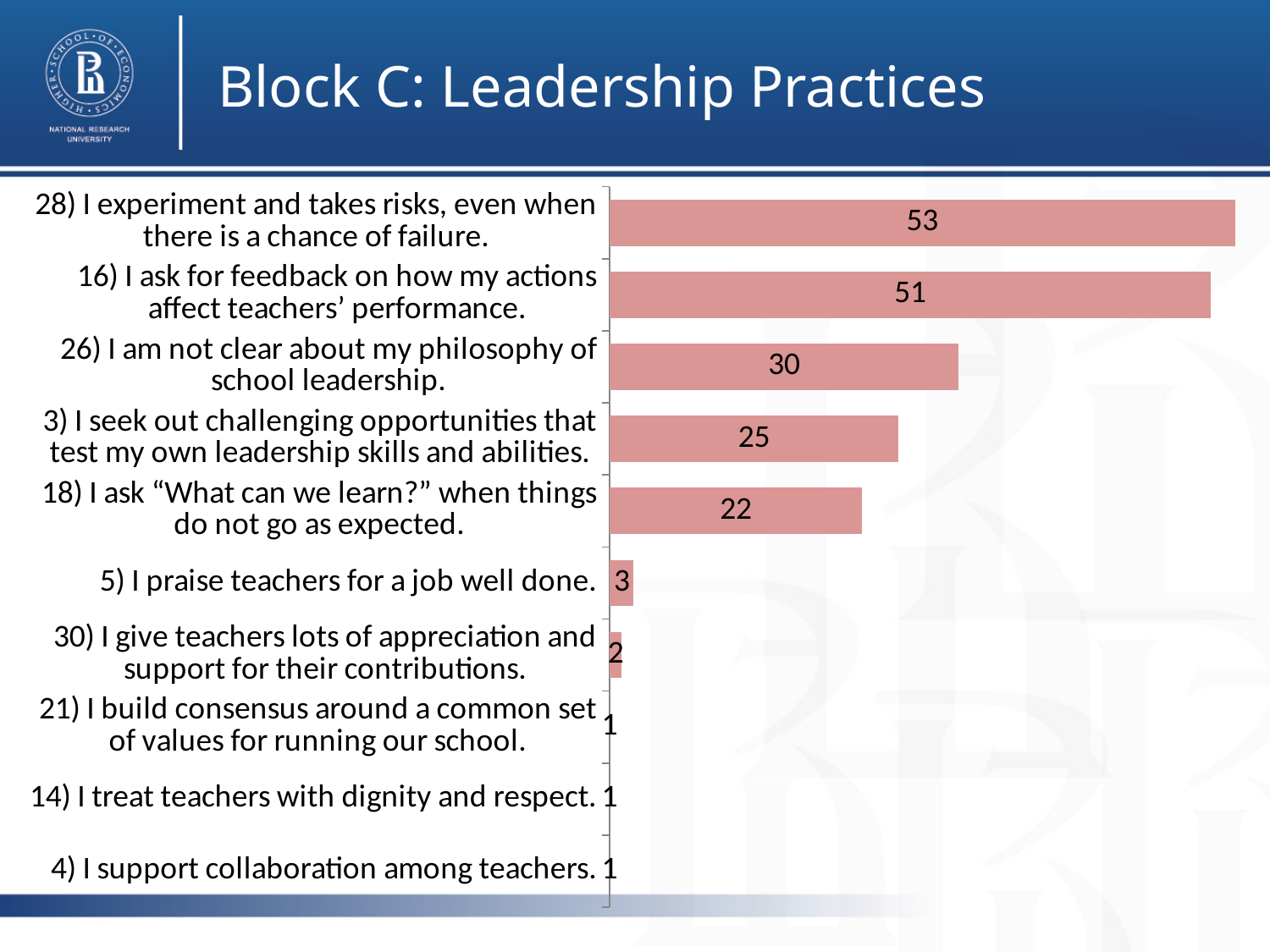
What is the difference between the values for "26) I am not clear about my philosophy of school leadership." and "3) I seek out challenging opportunities that test my own leadership skills and abilities."? 5 What is the value for "28) I experiment and takes risks, even when there is a chance of failure."? 53 What is the title of the slide containing the chart? Block C: Leadership Practices What is the value for "26) I am not clear about my philosophy of school leadership."? 30 What is the difference between the values for "28) I experiment and takes risks, even when there is a chance of failure." and "16) I ask for feedback on how my actions affect teachers' performance."? 2 What is the value for "18) I ask "What can we learn?" when things do not go as expected."? 22 What is the value for "5) I praise teachers for a job well done."? 3 What kind of chart is shown on the slide? Bar chart How many categories are shown in the chart? 10 Which category has the highest value? 28) I experiment and takes risks, even when there is a chance of failure. Which is larger: the value for "3) I seek out challenging opportunities that test my own leadership skills and abilities." or the value for "18) I ask "What can we learn?" when things do not go as expected."? 3) I seek out challenging opportunities that test my own leadership skills and abilities. What is the value for "16) I ask for feedback on how my actions affect teachers' performance."? 51